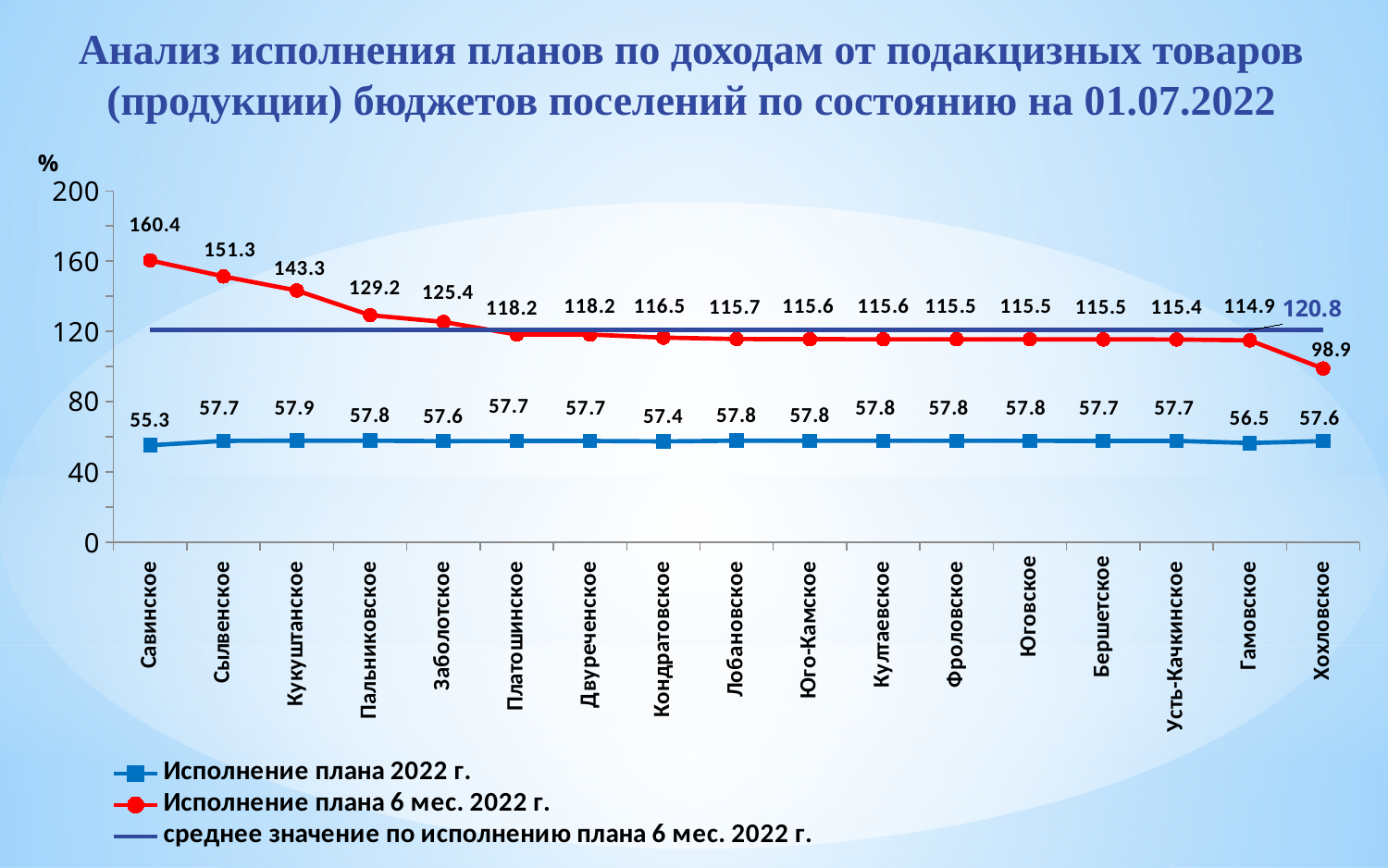
For "Исполнение плана 6 мес. 2022 г.", which is larger: Кукуштанское or Пальниковское? Кукуштанское How many settlements are shown on the x axis? 17 What is the value of the line "среднее значение по исполнению плана 6 мес. 2022 г."? 120.8 Which settlement has the highest value for "Исполнение плана 6 мес. 2022 г."? Савинское What kind of chart is shown on the slide? Line chart What is the value of "Исполнение плана 6 мес. 2022 г." for Савинское? 160.4 What is the difference between the "Исполнение плана 6 мес. 2022 г." values for Савинское and Хохловское? 61.5 Which settlement has the lowest value for "Исполнение плана 2022 г."? Савинское Does the "Исполнение плана 6 мес. 2022 г." series rise or fall from left to right along the x axis? Fall Which settlement has the lowest value for "Исполнение плана 6 мес. 2022 г."? Хохловское How many series does the legend list? 3 What is the value of "Исполнение плана 2022 г." for Хохловское? 57.6